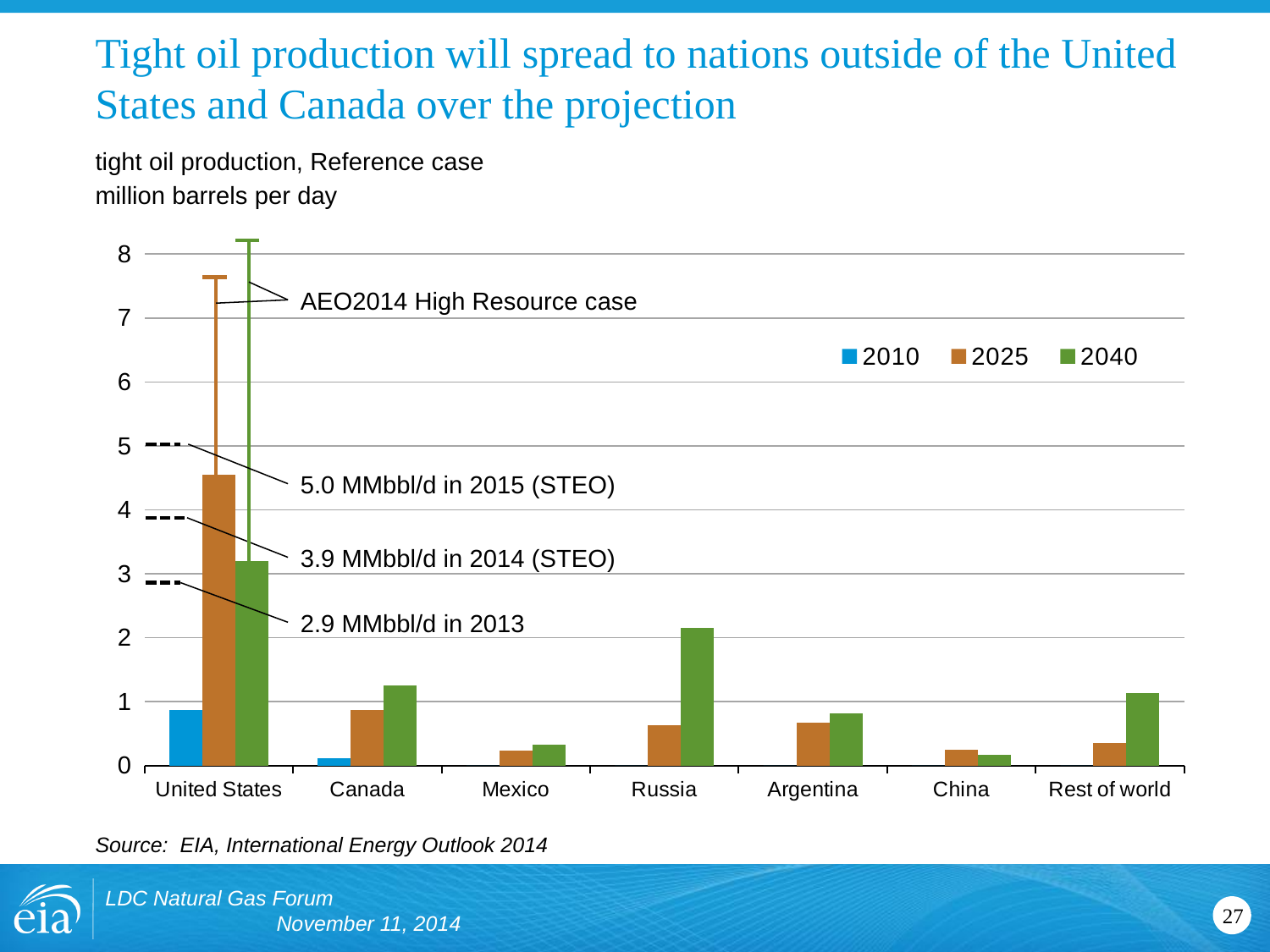
Is the 2040 value for China greater or less than 1? less How many series does the chart legend list? 3 What kind of chart is shown on the slide? bar chart Is the 2040 value for Russia greater or less than 2? greater Which country or region has the highest tight oil production in 2040? United States Do the values for Russia rise or fall from 2010 to 2040? rise Which country or region has the highest tight oil production in 2025? United States Which country or region has the lowest tight oil production in 2040? China Is the 2025 value for the United States greater or less than 4? greater According to the annotation on the chart, what was U.S. tight oil production in 2013? 2.9 MMbbl/d How many countries or regions are shown on the x axis of the chart? 7 Which is larger, the 2040 value for Russia or the 2040 value for Canada? Russia